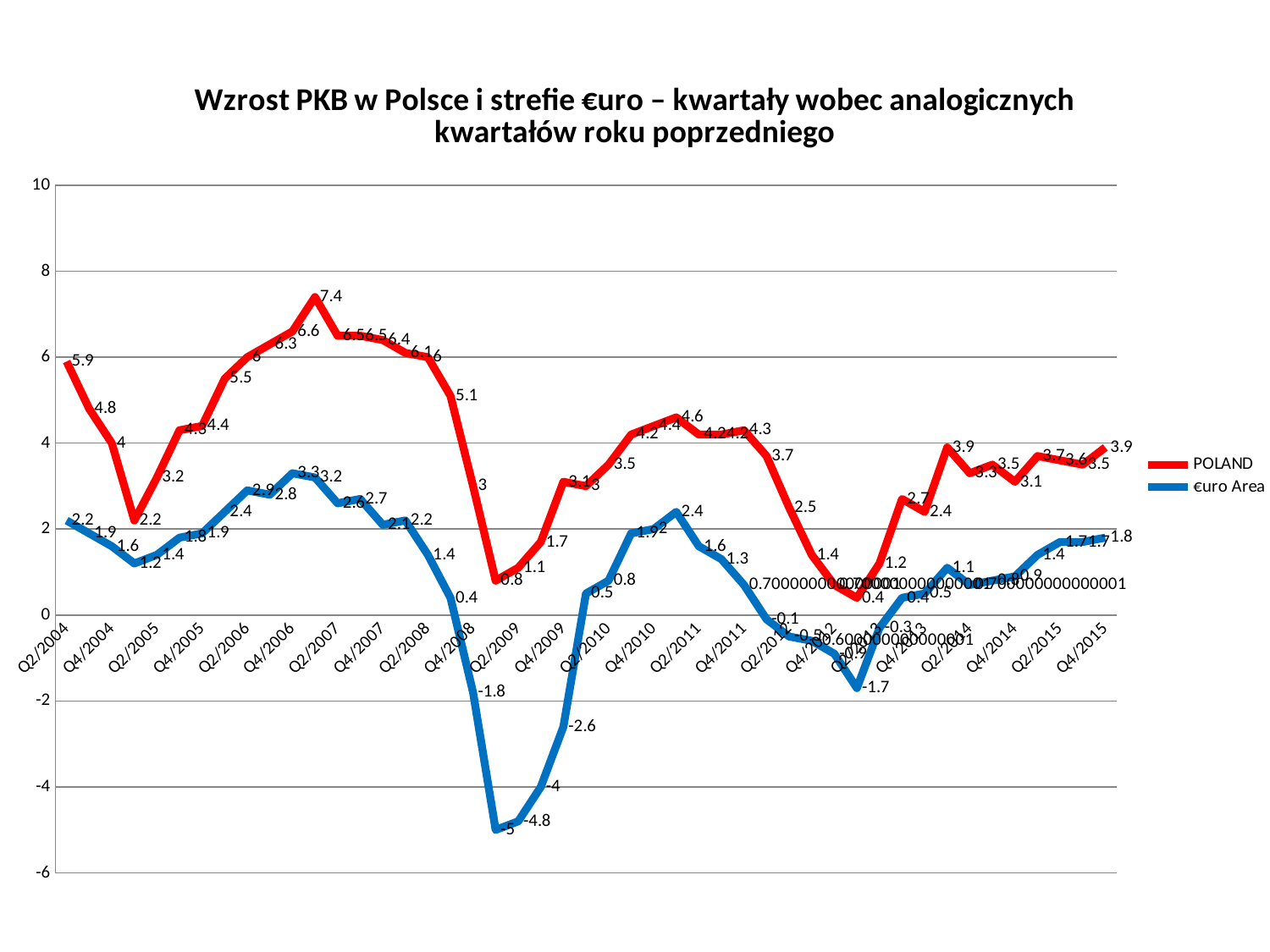
What is the difference between the POLAND value (3.9) and the €uro Area value (1.8) at Q4/2015? 2.1 What are the two series named in the legend? POLAND and €uro Area What is the lowest value on the €uro Area line? -5 Which series has the higher value at Q2/2004, POLAND or €uro Area? POLAND Does the POLAND line rise or fall from Q2/2004 to Q4/2004? fall How many series does the legend list? 2 What is the highest value on the POLAND line? 7.4 What is the lowest value on the POLAND line? 0.4 What is the highest value on the €uro Area line? 3.3 What is the €uro Area value at Q4/2015? 1.8 What is the POLAND value at Q2/2004? 5.9 What kind of chart is shown on the slide? line chart